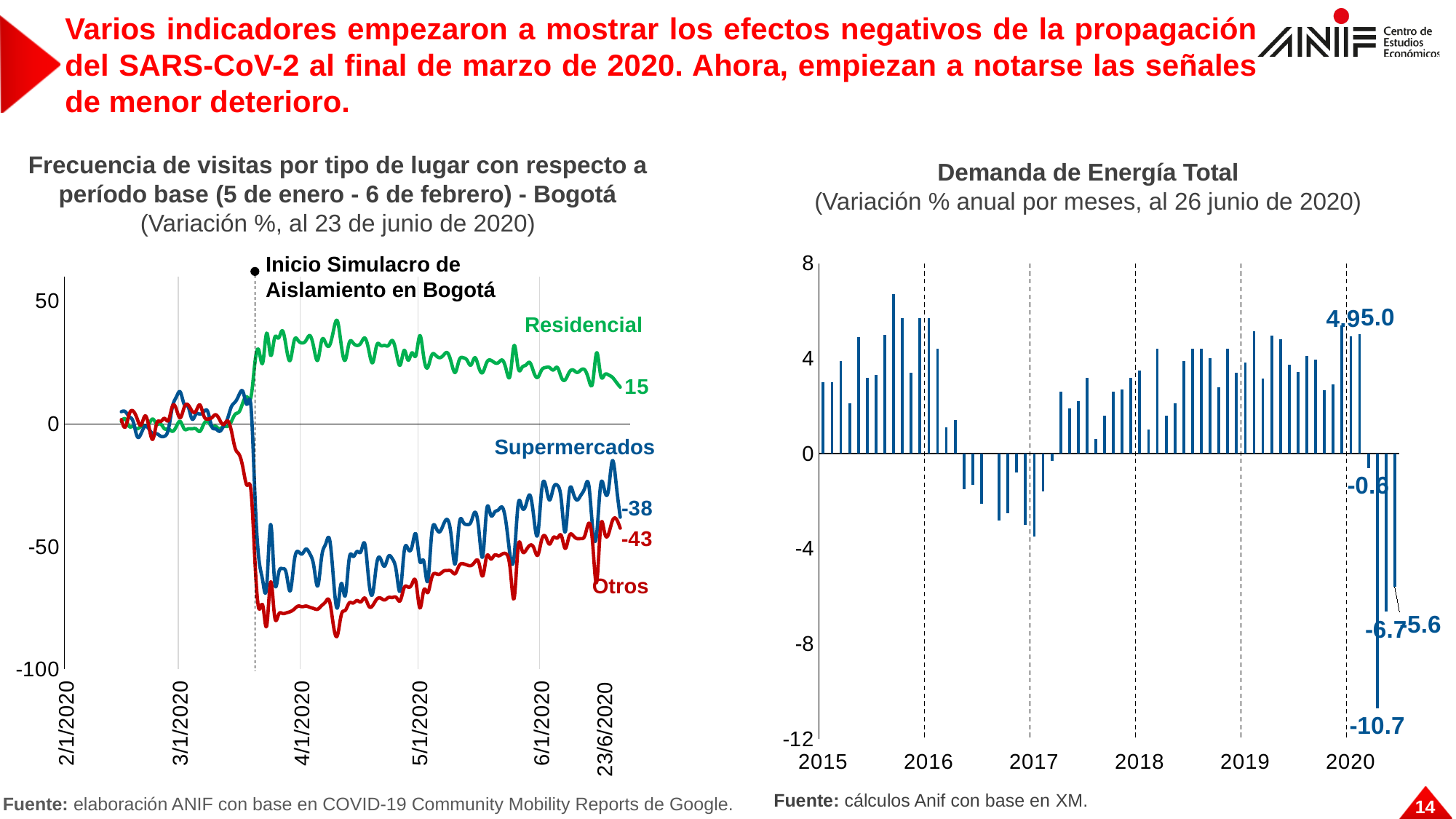
In the right chart (Demanda de Energía Total), what is the difference between the highest labeled value (5.0) and the lowest labeled value (-10.7)? 15.7 In the left chart (Frecuencia de visitas por tipo de lugar), which series has the lowest value at the end of the period? Otros In the left chart (Frecuencia de visitas por tipo de lugar), which series has the highest value at the end of the period? Residencial What kind of chart is the right chart (Demanda de Energía Total)? Bar chart What kind of chart is the left chart (Frecuencia de visitas por tipo de lugar)? Line chart In the right chart (Demanda de Energía Total), what is the lowest labeled value? -10.7 In the left chart (Frecuencia de visitas por tipo de lugar), what is the final value shown for the Residencial series? 15 In the left chart (Frecuencia de visitas por tipo de lugar), what event does the annotation at the dashed vertical line mark? Inicio Simulacro de Aislamiento en Bogotá In the left chart (Frecuencia de visitas por tipo de lugar), what is the difference between the final values of Supermercados and Otros? 5 In the left chart (Frecuencia de visitas por tipo de lugar), what is the final value shown for the Supermercados series? -38 How many series are plotted in the left chart (Frecuencia de visitas por tipo de lugar)? 3 In the left chart (Frecuencia de visitas por tipo de lugar), what is the final value shown for the Otros series? -43